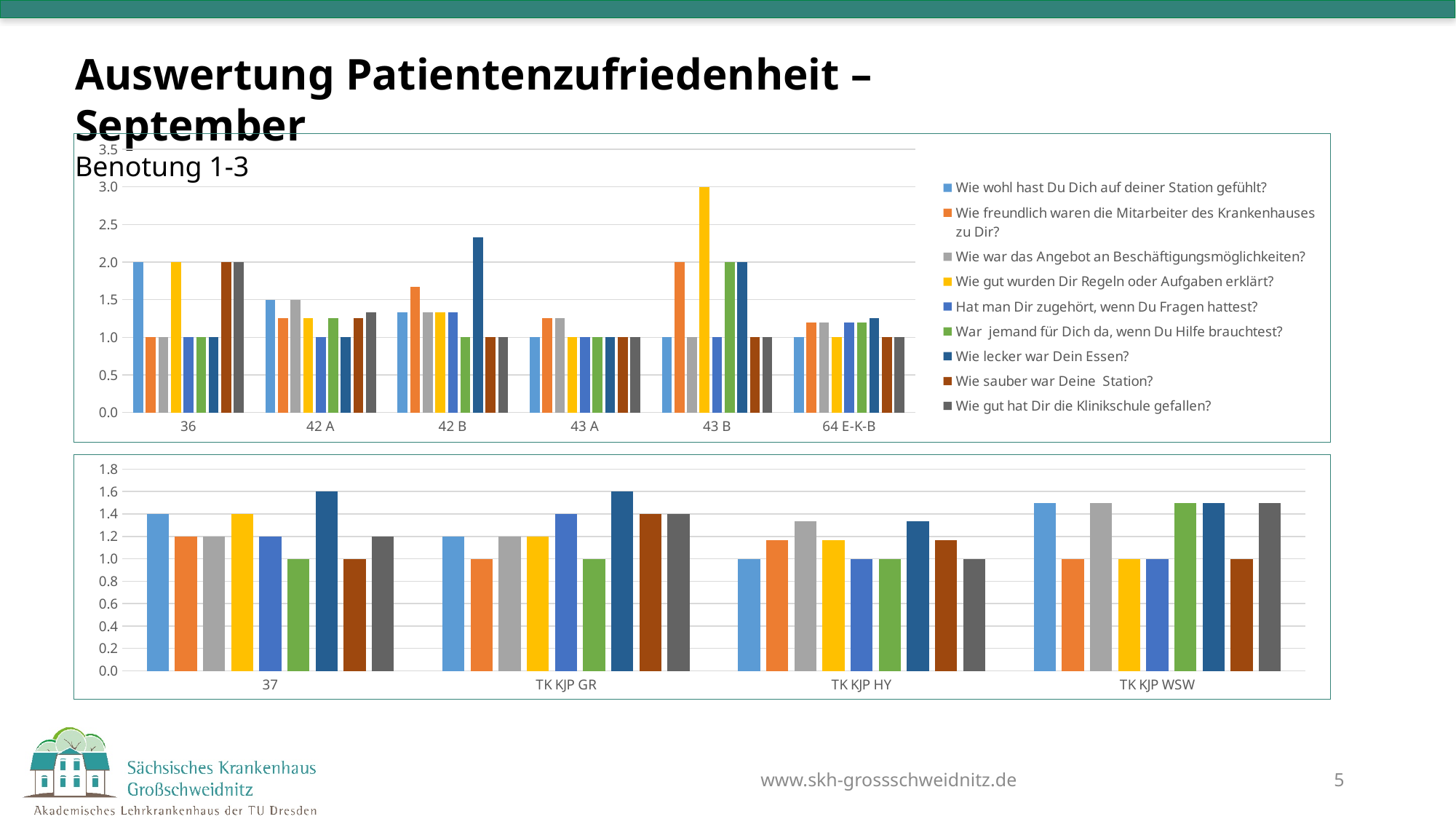
How many series does the legend of the top chart list? 9 In the bottom chart, what is the difference between the value for "Wie wohl hast Du Dich auf deiner Station gefühlt?" in category 37 and in category TK KJP HY? 0.4 In the top chart, is the value for "Wie lecker war Dein Essen?" in category 42 B greater or less than 2.0? greater In the bottom chart, is the value for "Wie war das Angebot an Beschäftigungsmöglichkeiten?" in category TK KJP HY greater or less than 1.2? greater In the bottom chart, what is the value for "Wie wohl hast Du Dich auf deiner Station gefühlt?" in category TK KJP HY? 1.0 How many categories are shown on the x axis of the top chart? 6 In the top chart, what is the value for "Wie gut wurden Dir Regeln oder Aufgaben erklärt?" in category 43 B? 3.0 In the top chart, what is the value for "Wie wohl hast Du Dich auf deiner Station gefühlt?" in category 36? 2.0 In the bottom chart, what is the value for "Wie lecker war Dein Essen?" in category 37? 1.6 In the top chart, which category contains the highest bar overall? 43 B In the bottom chart, which series has the highest value in category TK KJP GR? Wie lecker war Dein Essen? In the bottom chart, is the value for "Wie wohl hast Du Dich auf deiner Station gefühlt?" larger in category 37 or in category TK KJP HY? 37